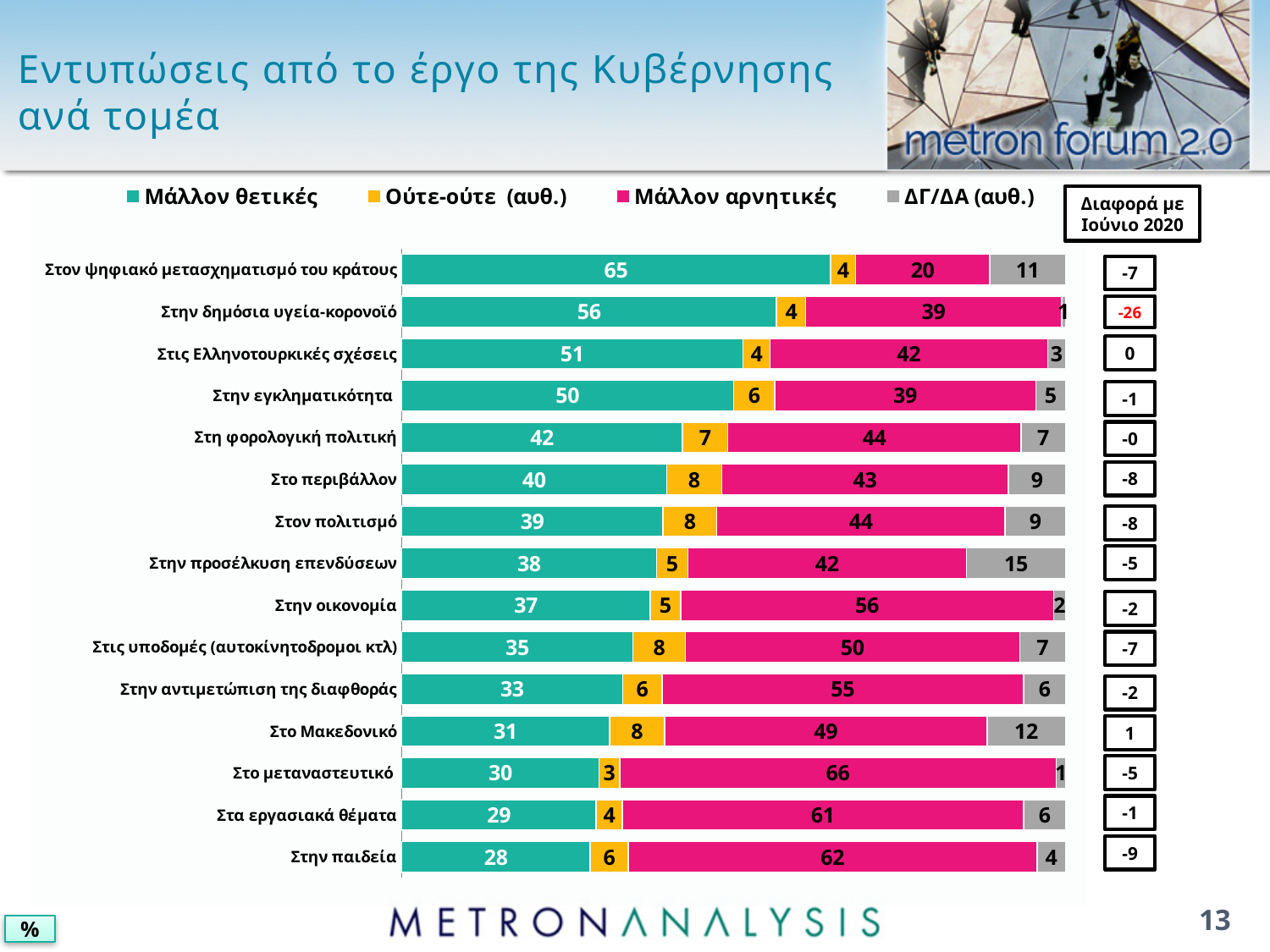
What is the difference between the 'Μάλλον αρνητικές' value for 'Στην παιδεία' and for 'Στον ψηφιακό μετασχηματισμό του κράτους'? 42 How many series does the legend list? 4 How many categories (sectors) are plotted in the chart? 15 Which category has the highest 'Μάλλον θετικές' value? Στον ψηφιακό μετασχηματισμό του κράτους Which category has the lowest 'Μάλλον θετικές' value? Στην παιδεία What is the 'Διαφορά με Ιούνιο 2020' value shown for 'Στην δημόσια υγεία-κορονοϊό'? -26 What is the value of 'Μάλλον θετικές' for 'Στον ψηφιακό μετασχηματισμό του κράτους'? 65 What is the value of 'Μάλλον αρνητικές' for 'Στο μεταναστευτικό'? 66 Which category has the highest 'Μάλλον αρνητικές' value? Στο μεταναστευτικό What is the value of 'ΔΓ/ΔΑ (αυθ.)' for 'Στην προσέλκυση επενδύσεων'? 15 Which is larger: the 'Μάλλον θετικές' value for 'Στην οικονομία' or the 'Μάλλον αρνητικές' value for 'Στην οικονομία'? Μάλλον αρνητικές What type of chart is shown on the slide? Stacked bar chart